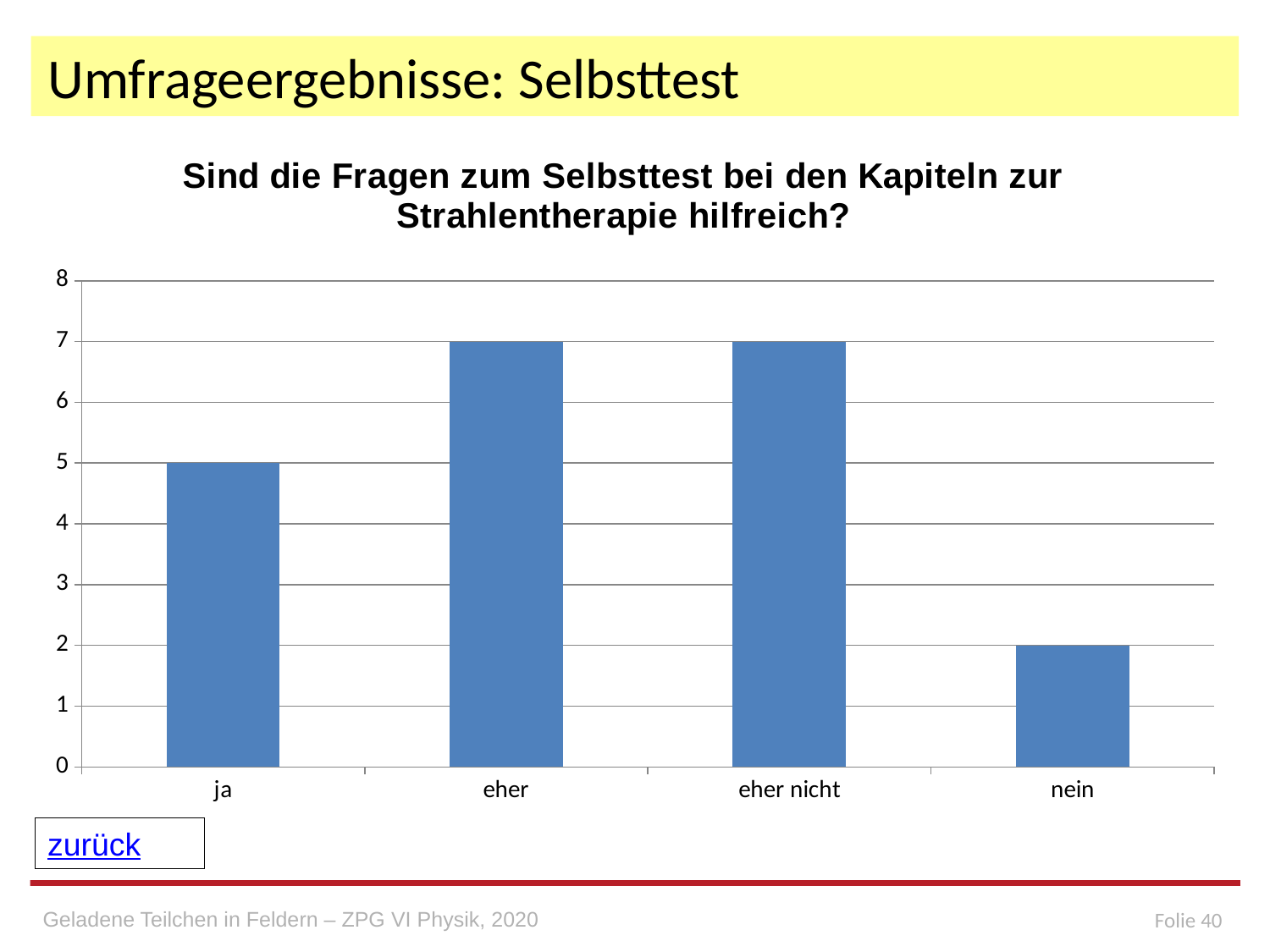
Is the value for "eher nicht" greater or less than 6? greater What is the title of the chart? Sind die Fragen zum Selbsttest bei den Kapiteln zur Strahlentherapie hilfreich? Which category has the lowest value? nein What is the value for "ja"? 5 What type of chart is shown on the slide? bar chart What is the value for "eher nicht"? 7 What is the difference between the values for "ja" and "nein"? 3 What is the difference between the values for "eher" and "ja"? 2 What is the value for "nein"? 2 Which is larger, the value for "ja" or the value for "nein"? ja How many categories are shown on the x axis? 4 What is the value for "eher"? 7